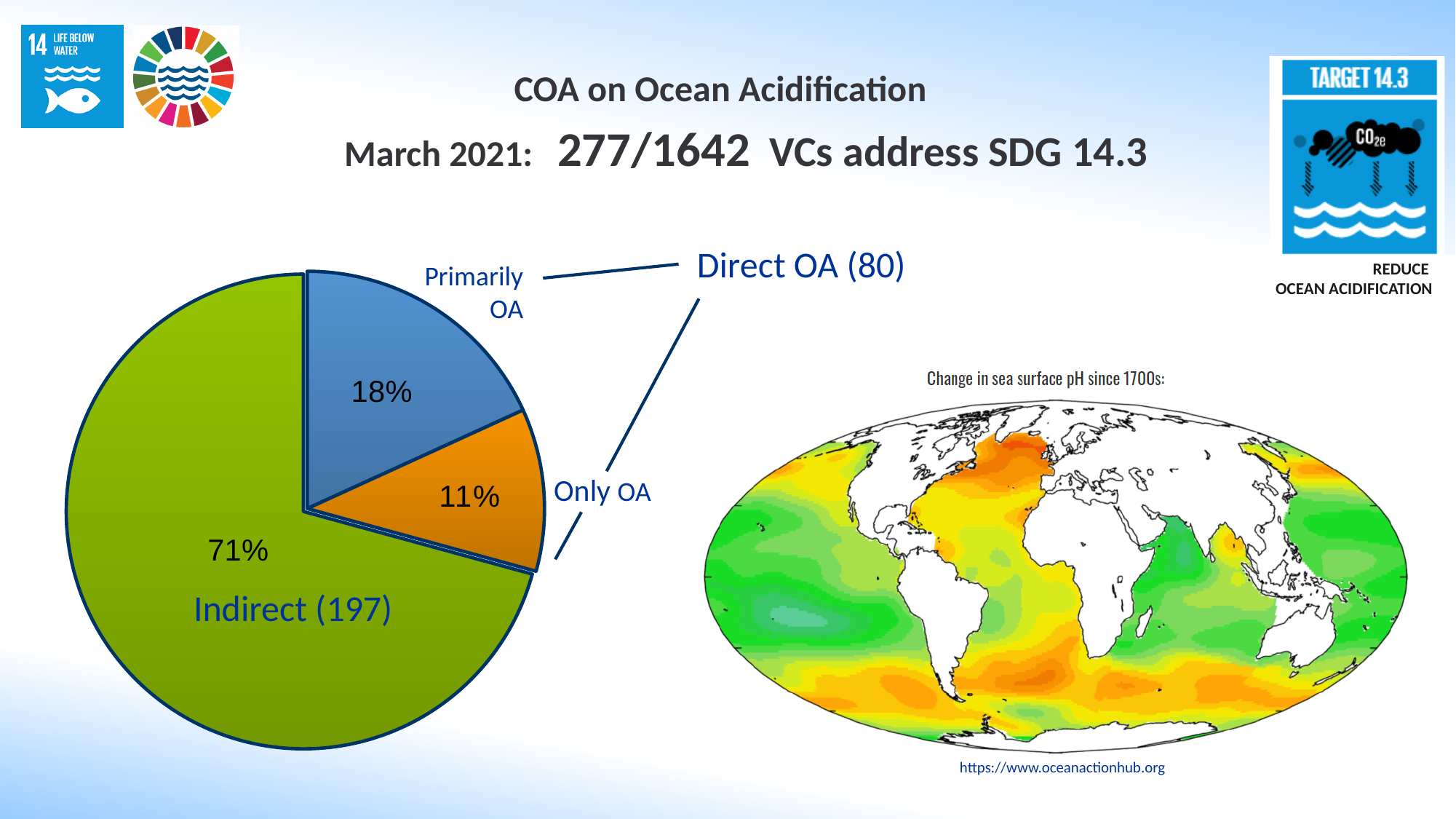
What type of chart is shown on the left of the slide? pie chart How many voluntary commitments are labelled as Direct OA on the slide? 80 How many slices does the pie chart have? 3 In the pie chart, what percentage is shown for the Indirect slice? 71% What is the difference in percentage points between the Primarily OA slice and the Only OA slice? 7 In the pie chart, what percentage is shown for the Primarily OA slice? 18% How many voluntary commitments are labelled as Indirect in the pie chart? 197 Which is larger in the pie chart, the Primarily OA slice or the Only OA slice? Primarily OA What colour is the Indirect slice of the pie chart? green In the pie chart, what percentage is shown for the Only OA slice? 11% Which slice of the pie chart is the largest? Indirect Which slice of the pie chart is the smallest? Only OA